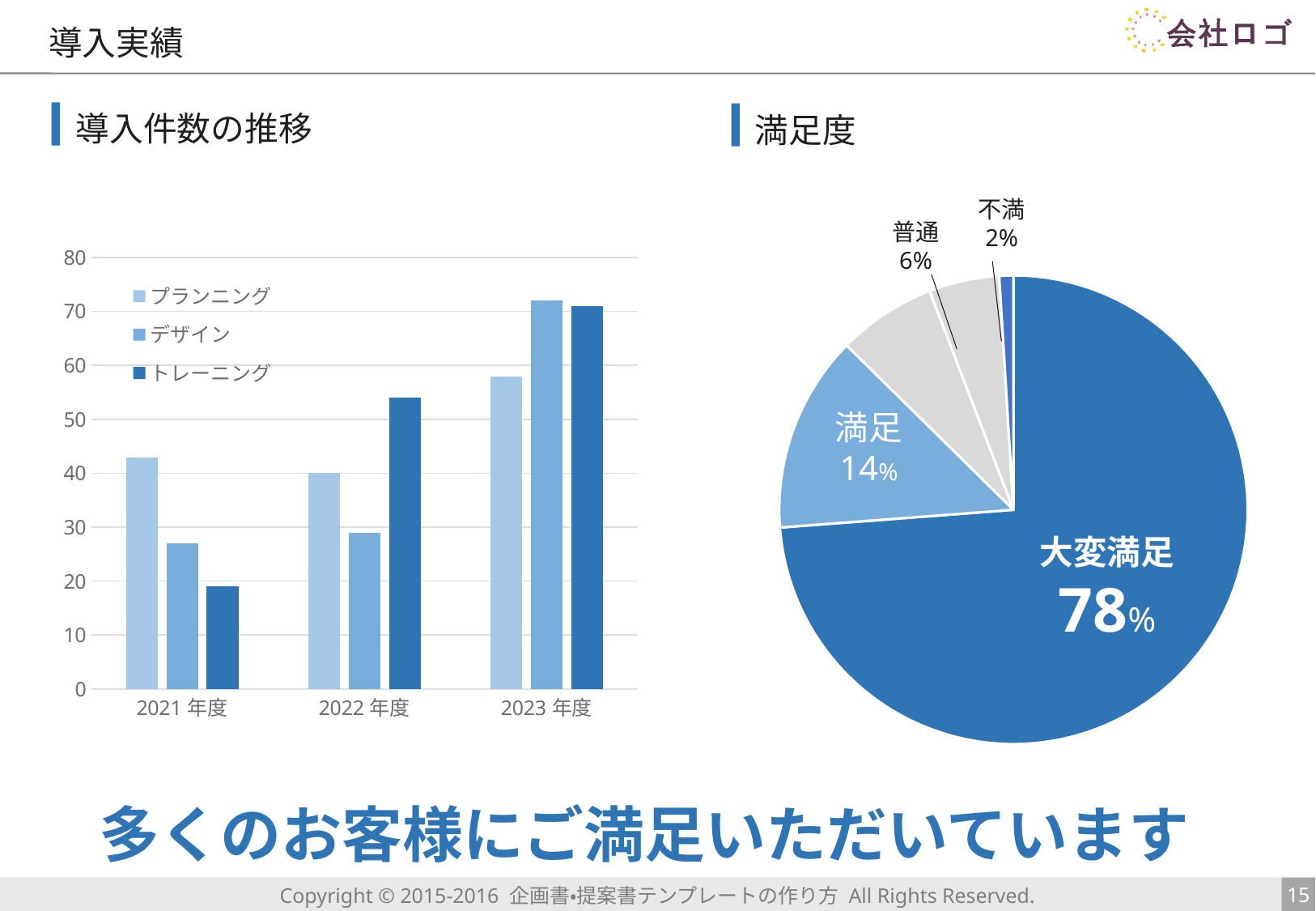
In the 導入件数の推移 chart, does the value for トレーニング rise or fall from 2021 年度 to 2023 年度? rise In the 導入件数の推移 chart, how many series does the legend list? 3 What kind of chart is the 導入件数の推移 chart on the left? bar chart In the 満足度 chart, which category has the smallest slice? 不満 In the 満足度 chart, what share of the pie is 大変満足? 78% In the 導入件数の推移 chart, how many year categories are shown on the x axis? 3 In the 導入件数の推移 chart, is the value for トレーニング in 2022 年度 greater or less than 50? greater In the 導入件数の推移 chart, which series has the lowest value in 2021 年度? トレーニング In the 満足度 chart, what is the difference between the 満足 share and the 普通 share? 8% What kind of chart is the 満足度 chart on the right? pie chart In the 導入件数の推移 chart, is the value for プランニング in 2021 年度 greater or less than 40? greater